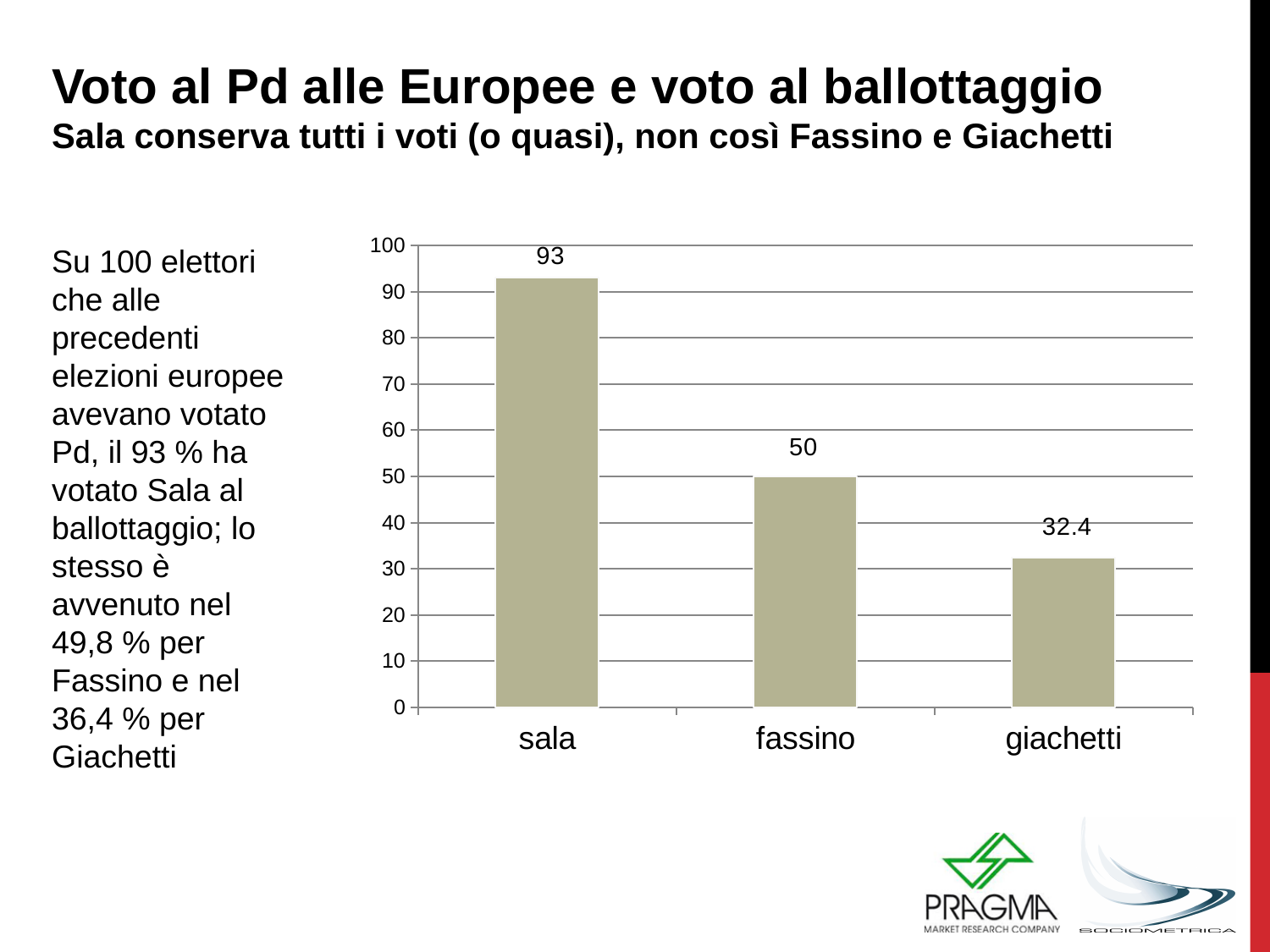
Is the value for giachetti greater or less than 40? less How many categories are shown on the x axis? 3 Which is larger, the value for fassino or the value for giachetti? fassino What is the difference between the values for sala and fassino? 43 Which category has the lowest value? giachetti What kind of chart is shown on the slide? bar chart What is the value for fassino? 50 What is the difference between the values for fassino and giachetti? 17.6 Which category has the highest value? sala What is the value for giachetti? 32.4 Do the values rise or fall from left to right along the x axis? fall What is the value for sala? 93